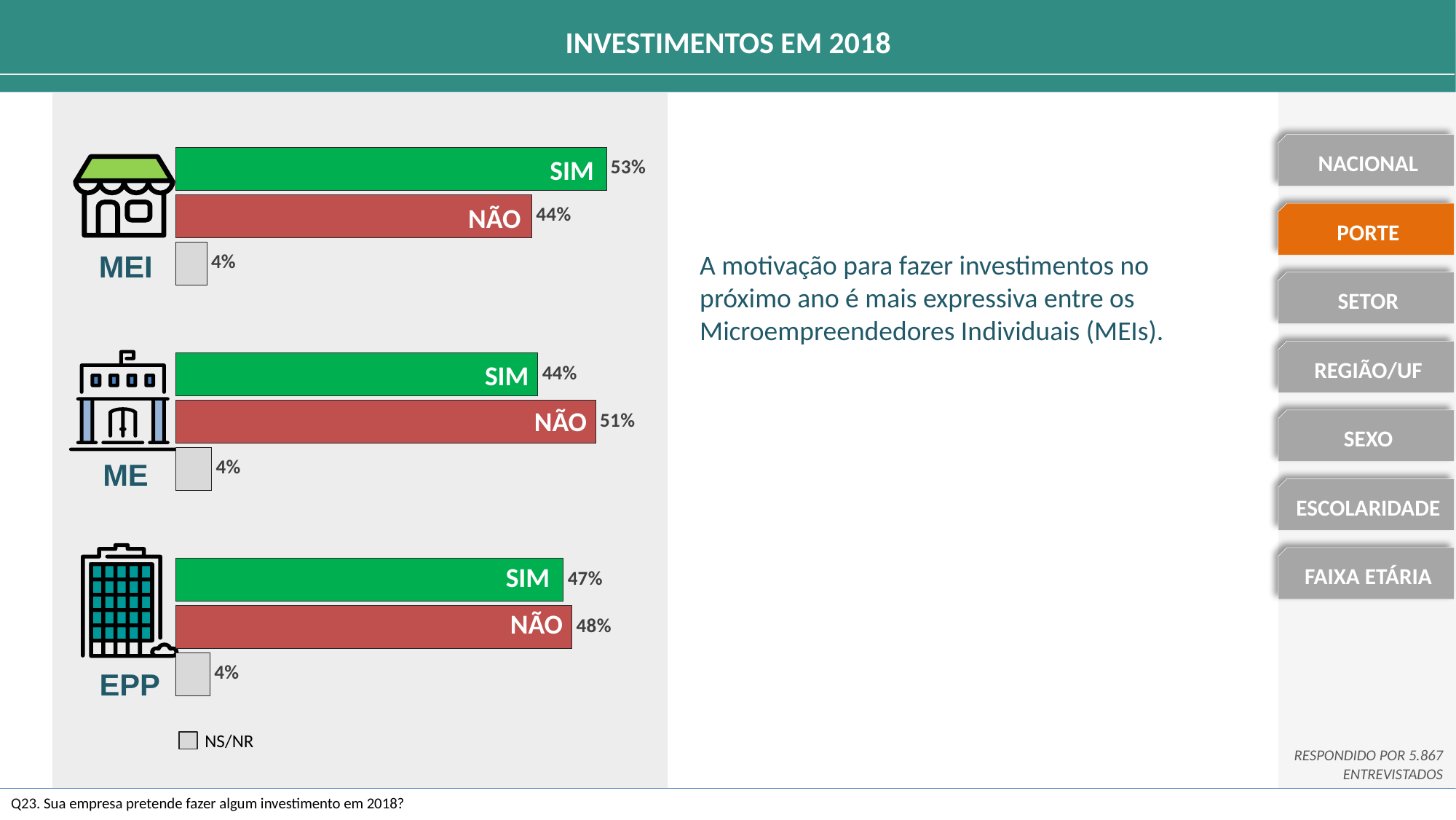
In the ME chart, which is larger, SIM or NÃO? NÃO In the MEI chart, which response has the highest value? SIM In the MEI chart, what is the difference between SIM and NÃO? 9 percentage points In the ME chart, which response has the lowest value? NS/NR Which group has the highest SIM percentage across the three charts: MEI, ME or EPP? MEI In the MEI chart, what percentage answered SIM? 53% In the ME chart, what is the difference between NÃO and SIM? 7 percentage points In the EPP chart, what percentage answered SIM? 47% In the EPP chart, what percentage is NS/NR? 4% What type of chart is used to show the MEI, ME and EPP results? Bar chart How many response categories are shown in each chart? 3 In the ME chart, what percentage answered NÃO? 51%